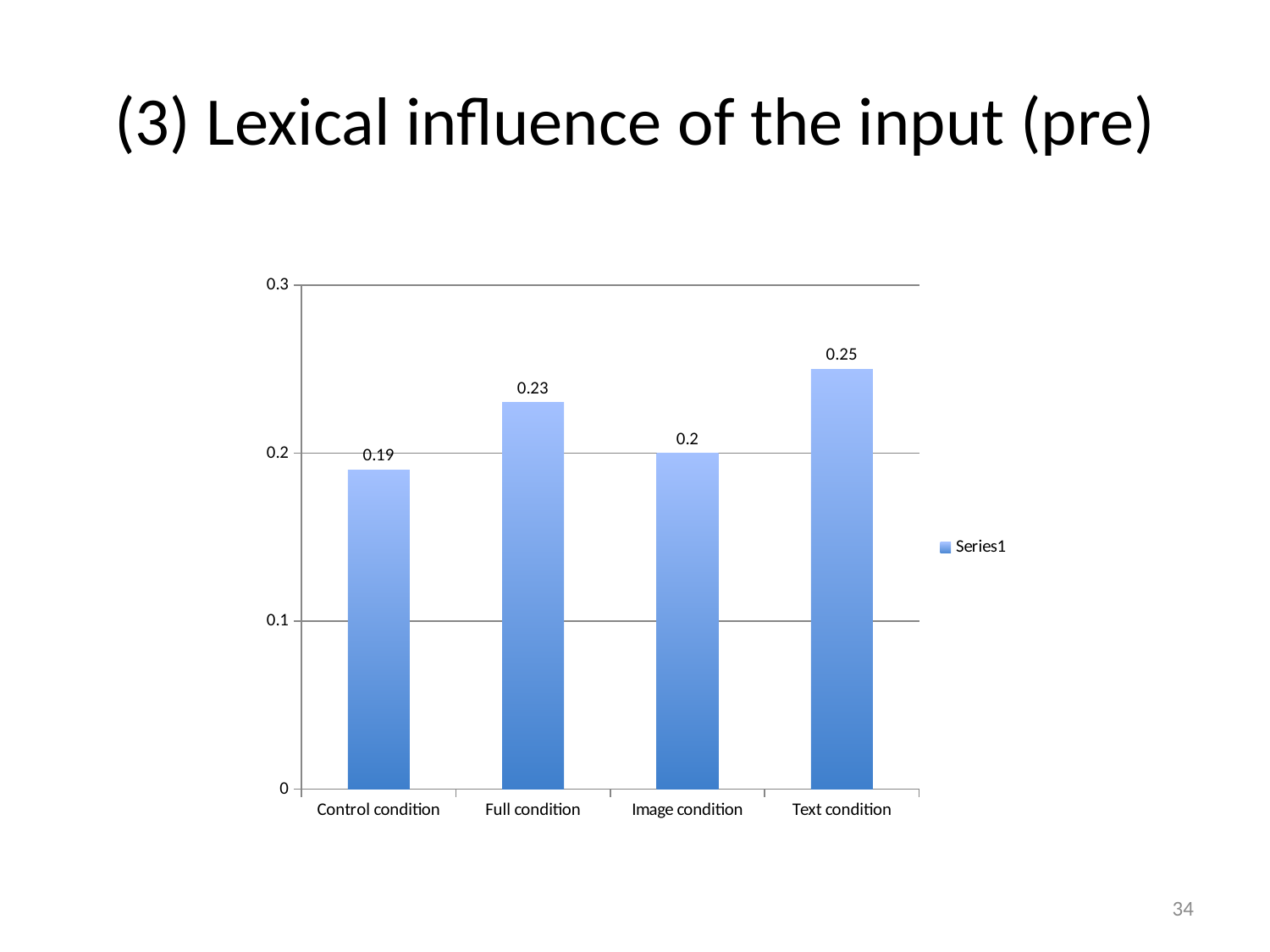
What is the value for Image condition? 0.2 What is the name of the series listed in the legend? Series1 What is the difference between the values for Text condition and Control condition? 0.06 What is the value for Text condition? 0.25 What is the value for Control condition? 0.19 Which condition has the highest value? Text condition What is the value for Full condition? 0.23 Which is larger, the value for Full condition or the value for Image condition? Full condition Which condition has the lowest value? Control condition What is the difference between the values for Full condition and Image condition? 0.03 What kind of chart is shown on the slide? Bar chart How many conditions are shown on the x axis? 4